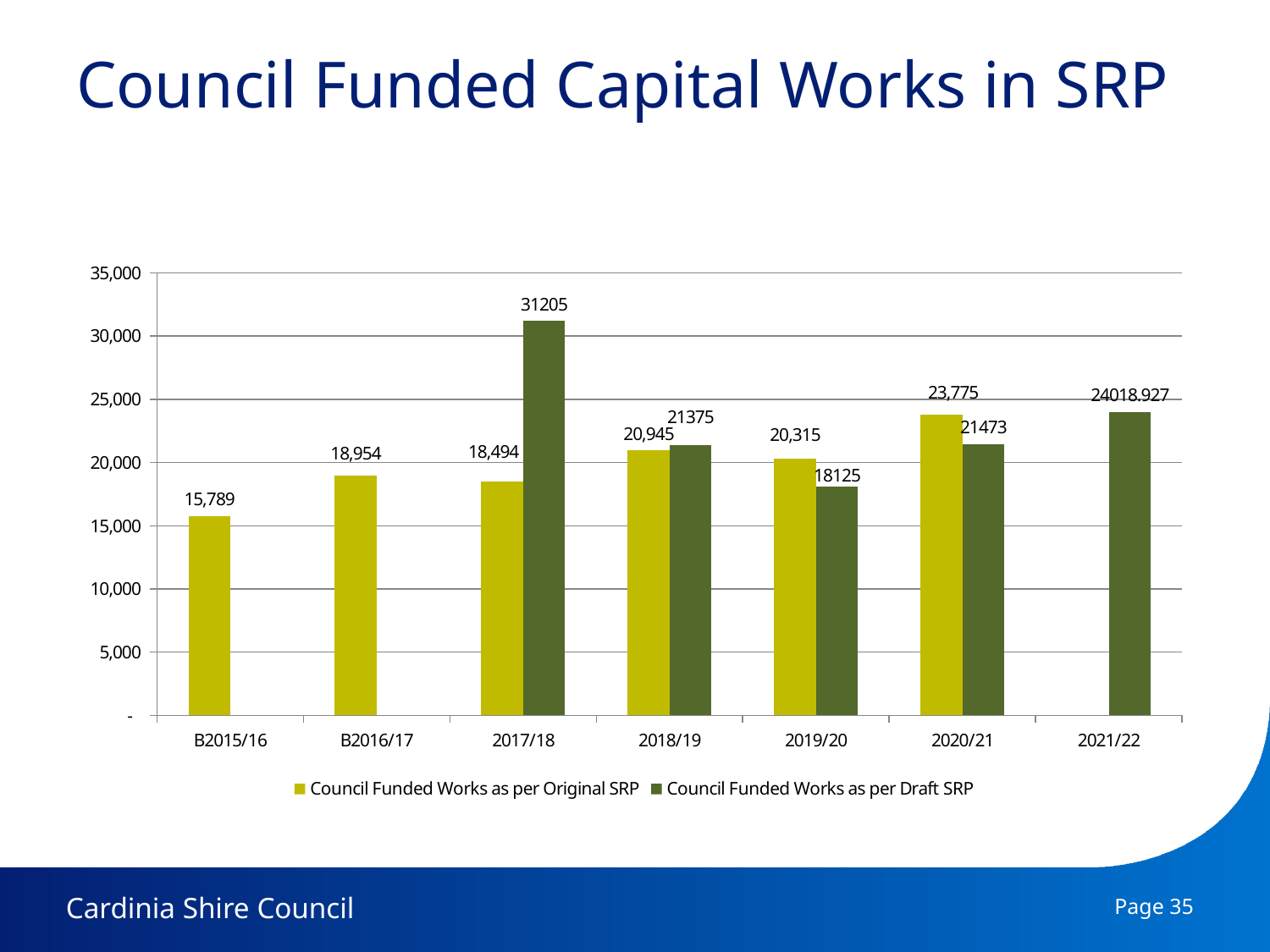
In which year is Council Funded Works as per Draft SRP highest? 2017/18 How many year categories are shown on the x axis? 7 In which year is Council Funded Works as per Original SRP lowest? B2015/16 For 2019/20, which is larger: Council Funded Works as per Original SRP or as per Draft SRP? Council Funded Works as per Original SRP What is the title of the slide? Council Funded Capital Works in SRP What is the value of Council Funded Works as per Draft SRP for 2021/22? 24018.927 What is the value of Council Funded Works as per Draft SRP for 2017/18? 31205 What kind of chart is shown on the slide? Bar chart What is the value of Council Funded Works as per Original SRP for 2020/21? 23,775 What is the value of Council Funded Works as per Original SRP for B2015/16? 15,789 How many series does the legend list? 2 For 2017/18, how much larger is the Draft SRP value than the Original SRP value? 12711